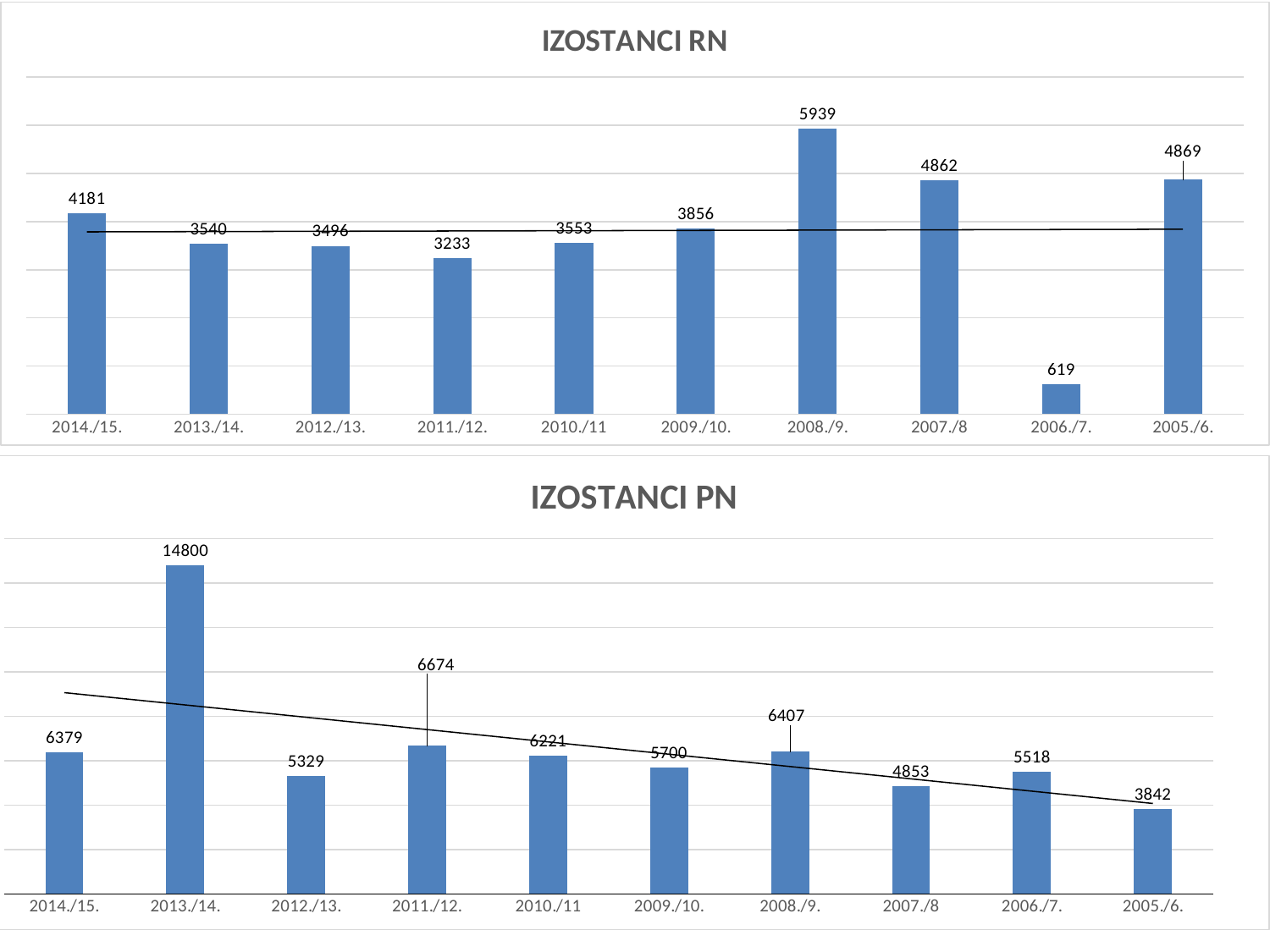
In the IZOSTANCI PN chart, which category has the lowest value? 2005./6. In the IZOSTANCI RN chart, how many categories are shown on the x axis? 10 In the IZOSTANCI PN chart, what is the value for 2013./14.? 14800 What kind of chart is the IZOSTANCI PN chart? Bar chart In the IZOSTANCI RN chart, which category has the highest value? 2008./9. In the IZOSTANCI PN chart, what is the difference between the values for 2014./15. and 2012./13.? 1050 In the IZOSTANCI PN chart, what is the value for 2007./8? 4853 In the IZOSTANCI RN chart, what is the difference between the values for 2005./6. and 2007./8? 7 What is the title of the top chart on the slide? IZOSTANCI RN In the IZOSTANCI RN chart, what is the value for 2008./9.? 5939 In the IZOSTANCI RN chart, which category has the lowest value? 2006./7. In the IZOSTANCI PN chart, which is larger, the value for 2011./12. or the value for 2008./9.? 2011./12.